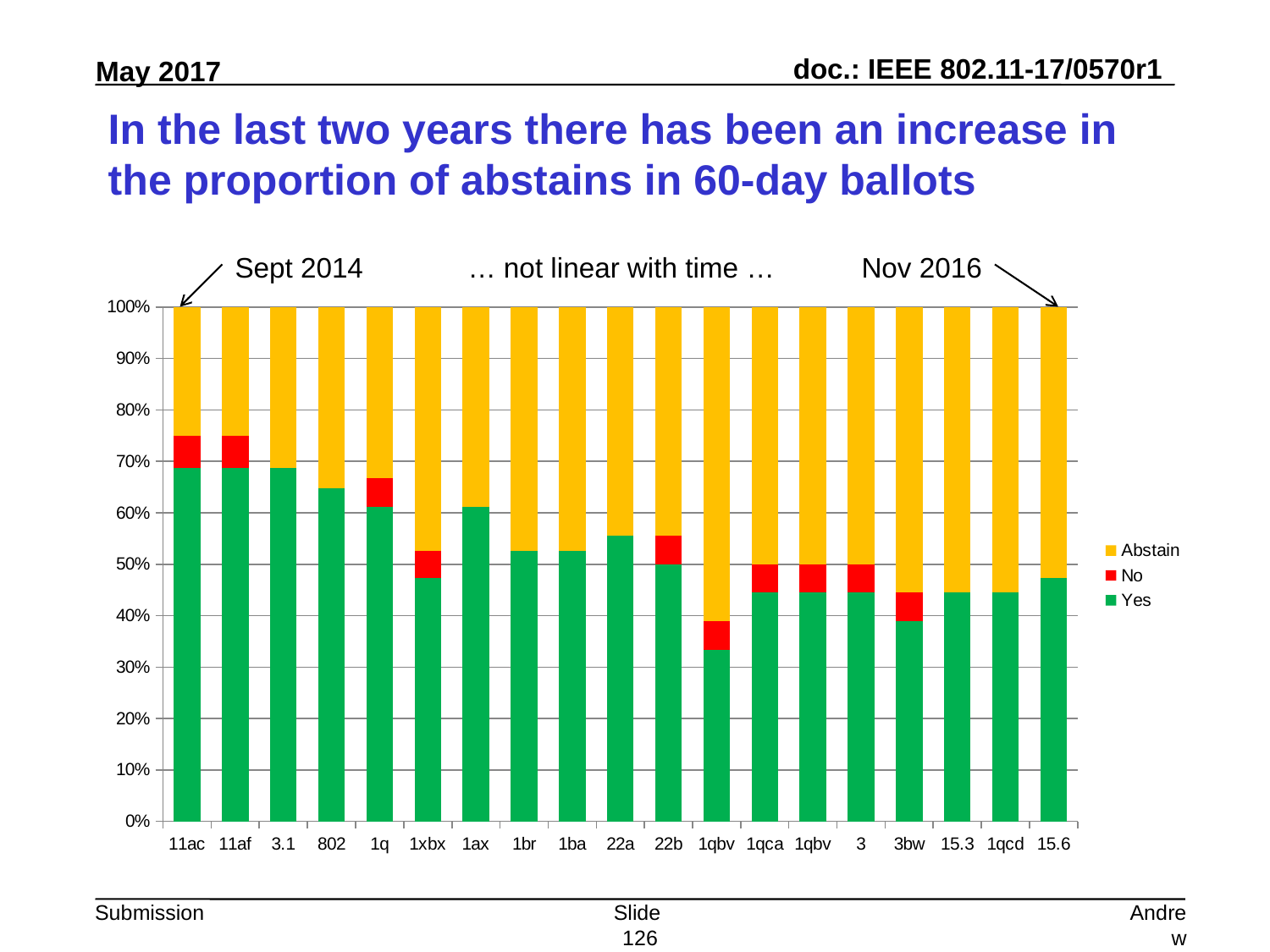
Is the Yes value for 1xbx greater or less than 50%? less What kind of chart is shown on the slide? stacked bar chart Is the Yes value for 11ac greater or less than 60%? greater Which series is shown in yellow in the legend? Abstain Is the Yes value for 802 greater or less than 60%? greater How many series does the legend list? 3 What does each stacked bar total? 100% How many categories are shown along the x axis? 19 Which has the larger Abstain share, 11ac or 15.6? 15.6 Which has the larger Yes share, 11ac or 1qca? 11ac Which series is shown in green in the legend? Yes